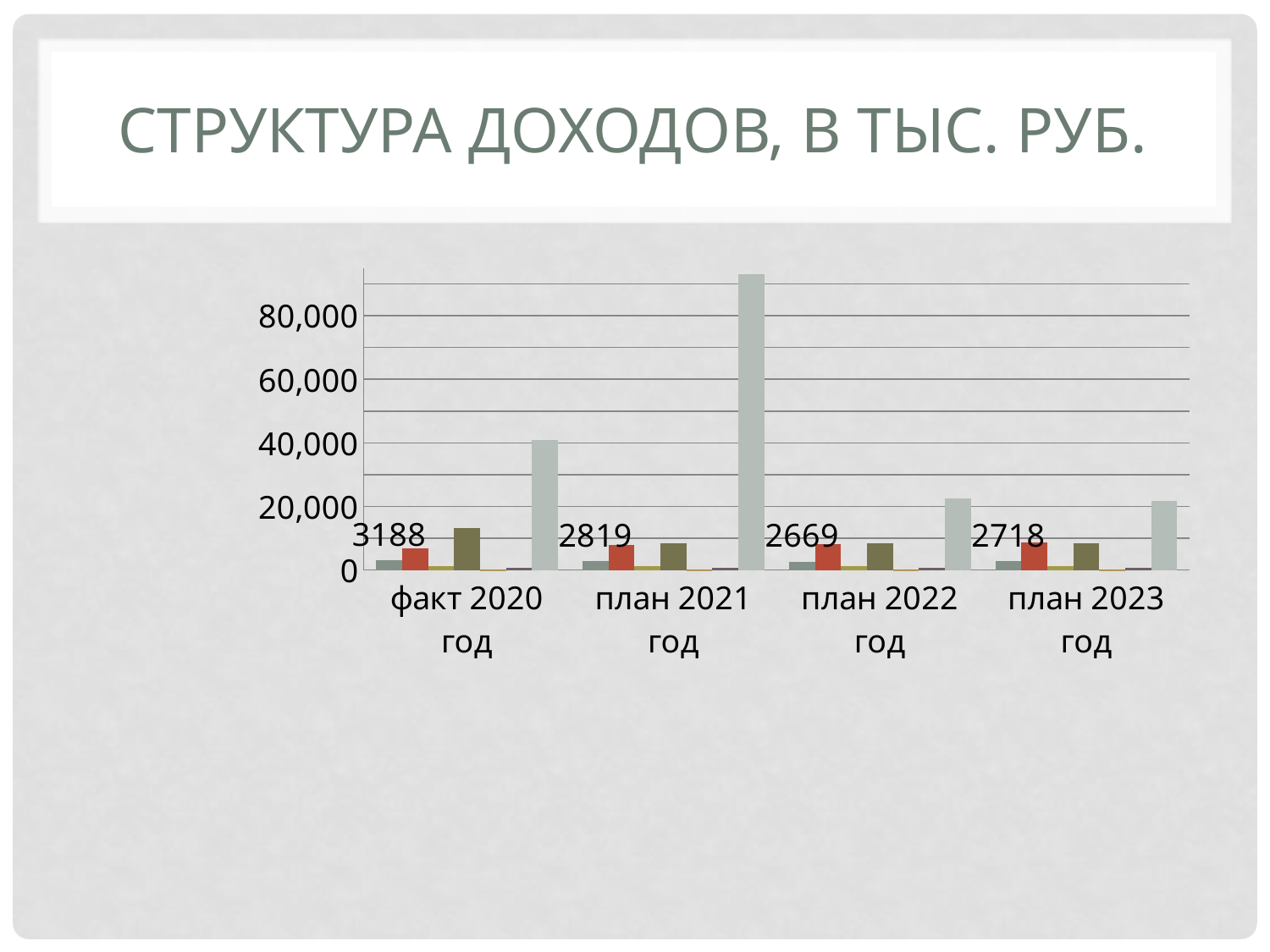
What is the labelled value for the first series in план 2022 год? 2669 Is the tallest bar in план 2021 год greater or less than 80,000? greater Among the labelled values (3188, 2819, 2669, 2718), which category has the highest? факт 2020 год What is the difference between the labelled values for факт 2020 год and план 2021 год? 369 Is the tallest bar in факт 2020 год greater or less than 60,000? less What is the title of the chart? СТРУКТУРА ДОХОДОВ, В ТЫС. РУБ. What is the labelled value for the first series in план 2023 год? 2718 How many categories are shown on the x axis? 4 Among the labelled values (3188, 2819, 2669, 2718), which category has the lowest? план 2022 год What is the labelled value for the first series in план 2021 год? 2819 What type of chart is shown on the slide? bar chart What is the labelled value for the first series in факт 2020 год? 3188